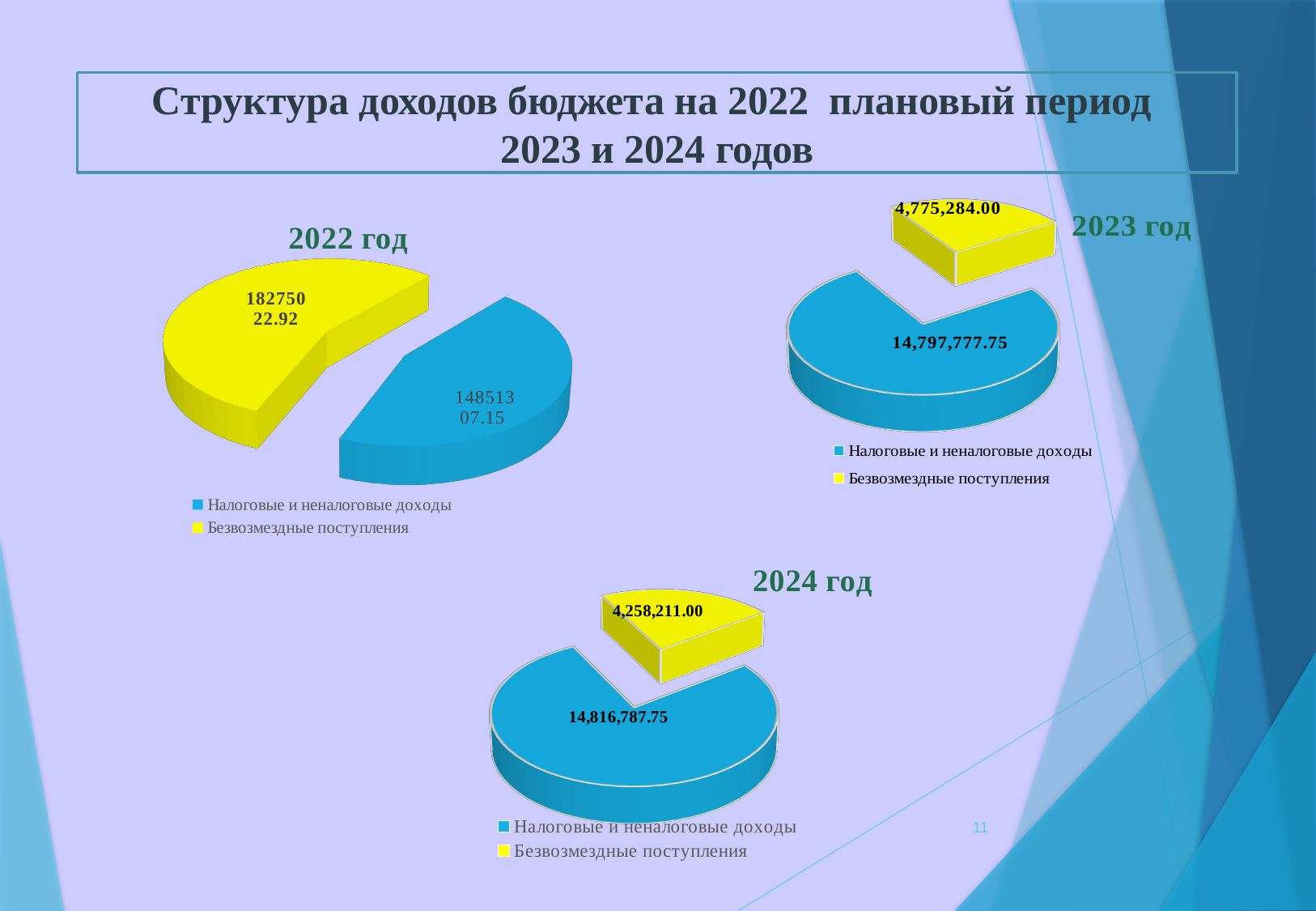
What kind of chart is used for the 2022 год chart? Pie chart In the 2023 год chart, what is the value for Безвозмездные поступления? 4,775,284.00 In the 2024 год chart, what is the value for Налоговые и неналоговые доходы? 14,816,787.75 How many categories does the legend of the 2024 год chart list? 2 In the 2023 год chart, what is the value for Налоговые и неналоговые доходы? 14,797,777.75 In the 2022 год chart, which slice is larger: Налоговые и неналоговые доходы or Безвозмездные поступления? Безвозмездные поступления In the 2024 год chart, what is the value for Безвозмездные поступления? 4,258,211.00 In the 2024 год chart, what is the total of the two slices? 19,074,998.75 In the 2023 год chart, what is the difference between Налоговые и неналоговые доходы and Безвозмездные поступления? 10,022,493.75 In the 2024 год chart, which category has the smallest slice? Безвозмездные поступления In the 2023 год chart, what colour is the slice for Безвозмездные поступления? Yellow In the 2023 год chart, which category has the largest slice? Налоговые и неналоговые доходы